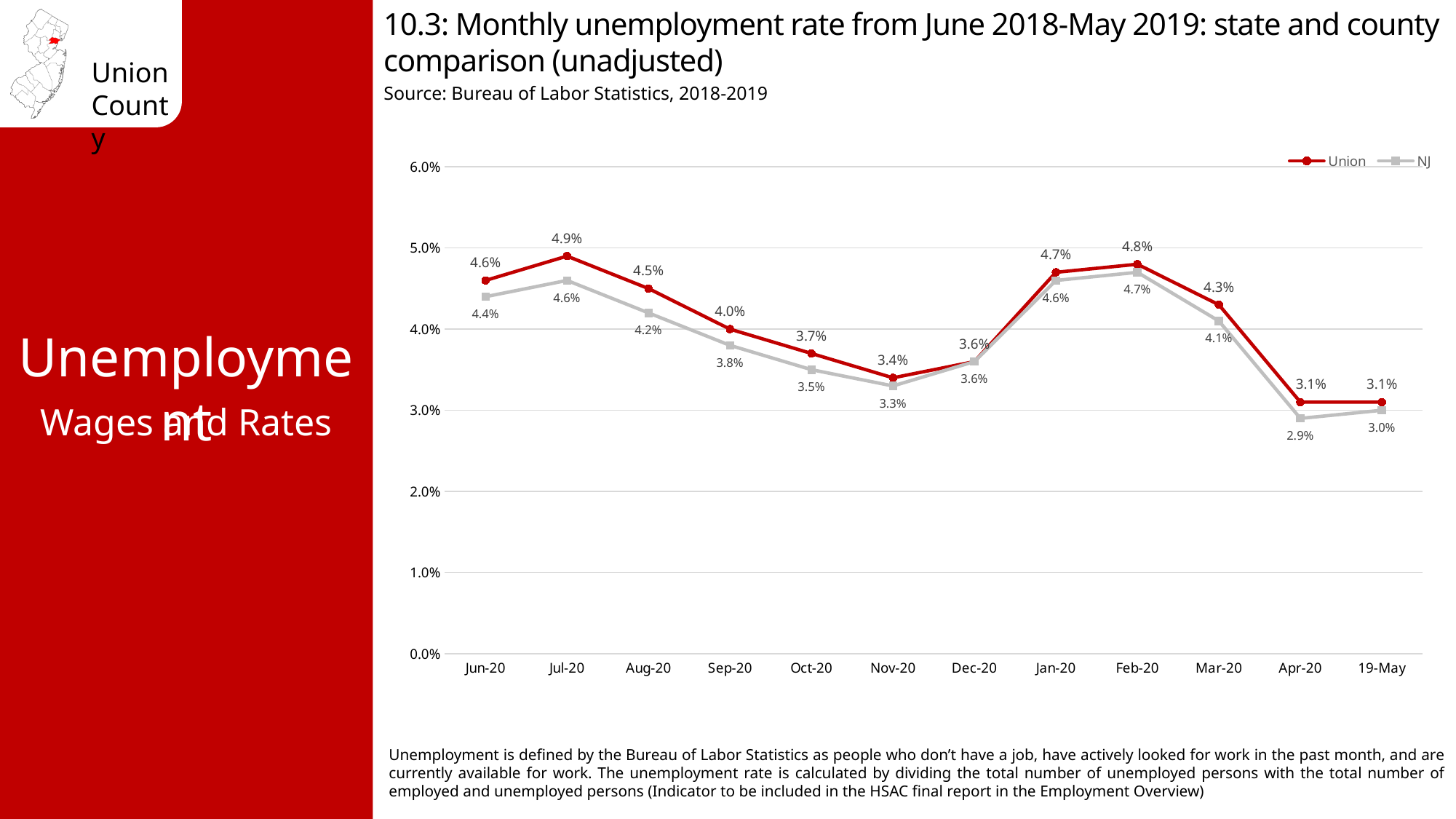
Which series has the higher value in Jan-20, Union or NJ? Union What is the Union unemployment rate for Jul-20? 4.9% What is the NJ unemployment rate for Nov-20? 3.3% In which month does the NJ series reach its lowest value? Apr-20 What kind of chart is shown on the slide? Line chart Does the Union series rise or fall from Feb-20 to Apr-20? Fall What is the difference between the Union and NJ rates in Sep-20? 0.2% What is the NJ unemployment rate for Apr-20? 2.9% Which series is drawn in red? Union How many series does the legend list? 2 How many months are plotted on the x axis? 12 In which month does the Union series reach its highest value? Jul-20